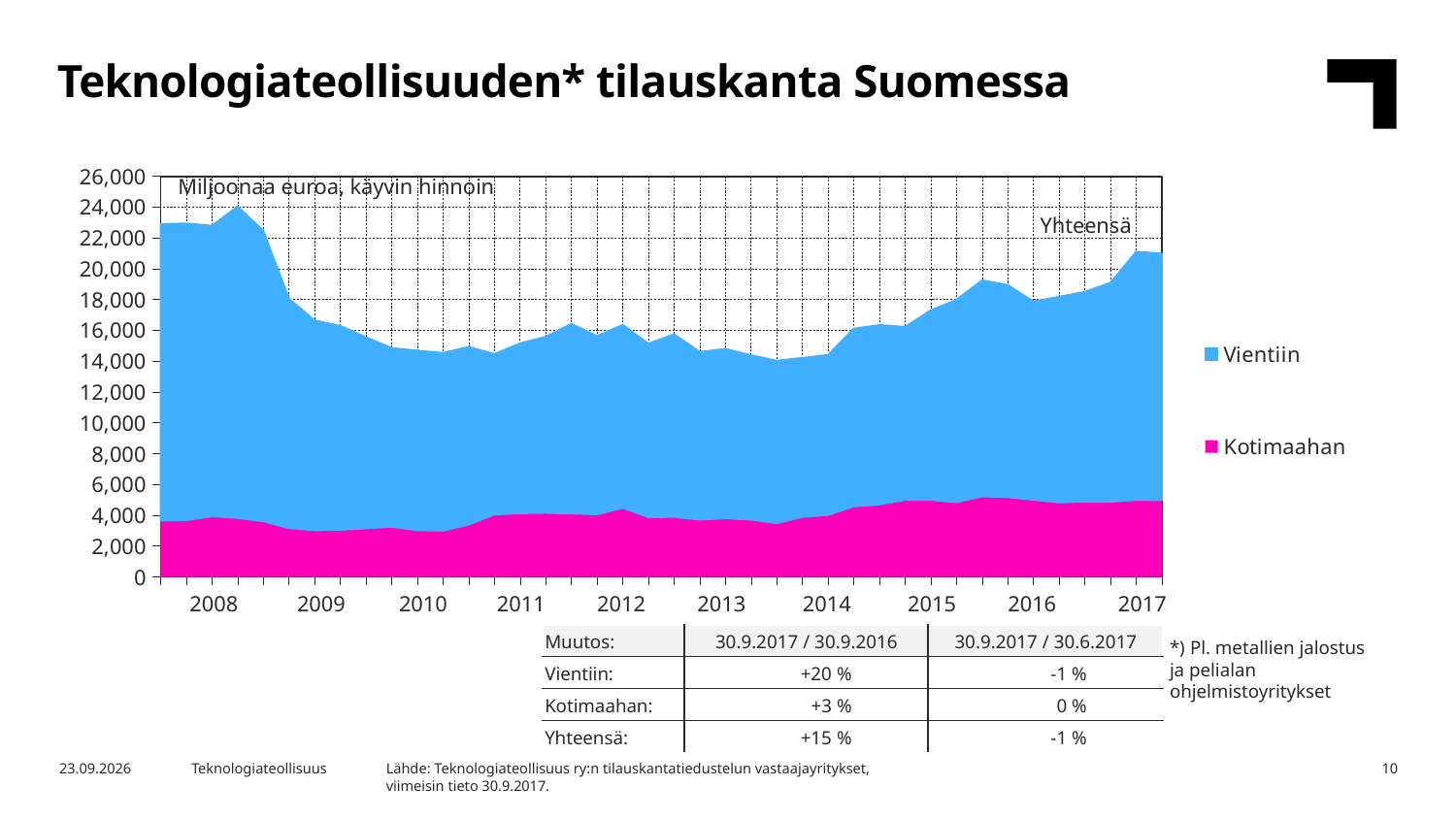
Which two series are listed in the chart legend? Vientiin and Kotimaahan How many years are labelled on the x axis? 10 What unit is stated in the chart's subtitle? Miljoonaa euroa, käyvin hinnoin Is the total (Yhteensä) order book at the start of 2008 greater or less than 20,000? greater Is the Kotimaahan value in 2017 greater or less than 6,000? less Which series is larger throughout the chart, Vientiin or Kotimaahan? Vientiin Is the Kotimaahan value in 2010 greater or less than 4,000? less How many series does the chart legend list? 2 Does the total order book rise or fall between 2008 and 2010? fall What kind of chart is shown on the slide? Stacked area chart